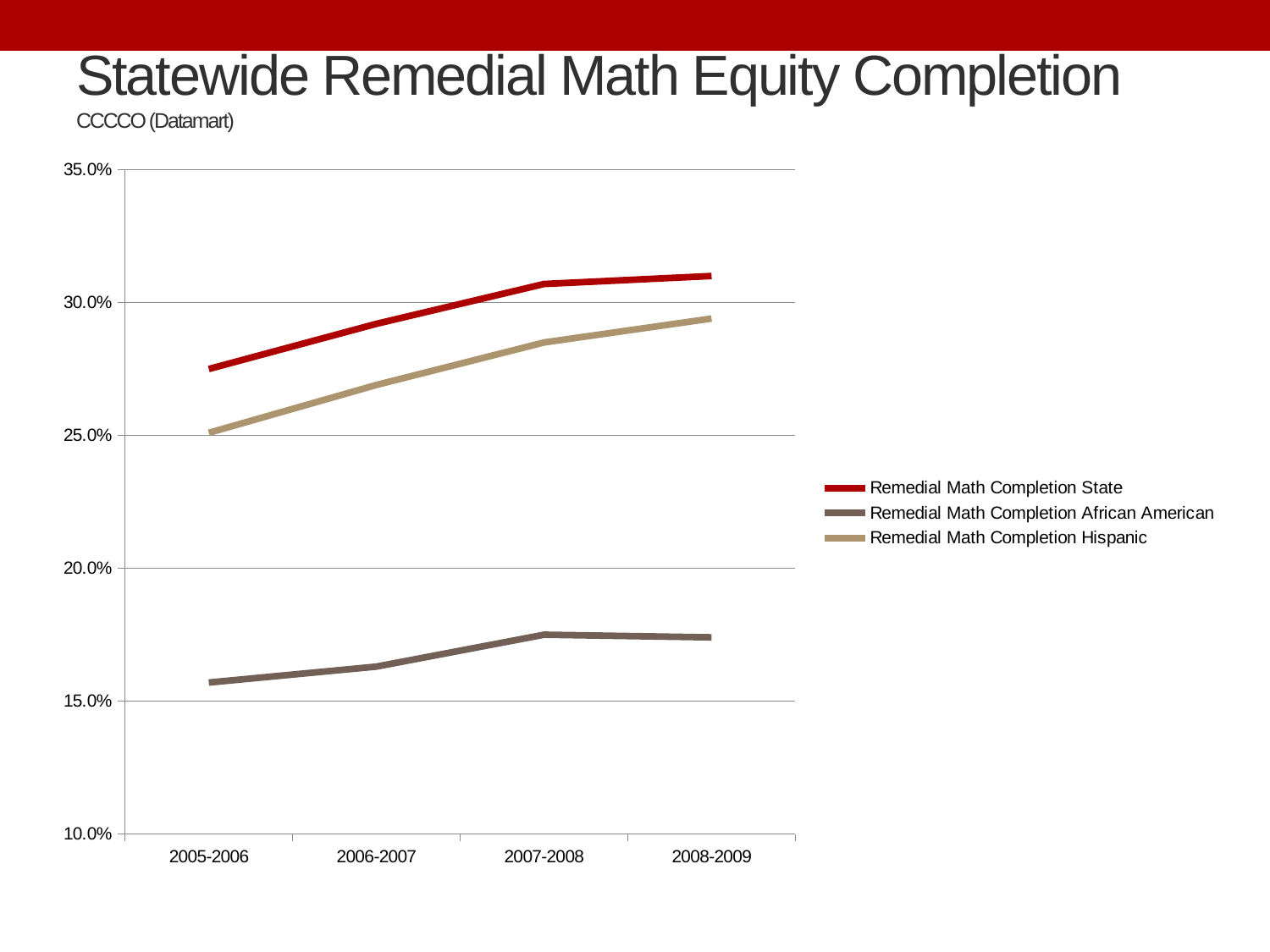
What is the title of the chart on the slide? Statewide Remedial Math Equity Completion How many academic years are shown on the x axis? 4 Does the Remedial Math Completion State line rise or fall from 2005-2006 to 2008-2009? rise Is the value for Remedial Math Completion Hispanic in 2008-2009 greater or less than 30.0%? less How many series does the legend list? 3 In 2007-2008, which is larger: Remedial Math Completion Hispanic or Remedial Math Completion African American? Remedial Math Completion Hispanic Which series has the lowest value in 2005-2006? Remedial Math Completion African American Is the value for Remedial Math Completion State in 2005-2006 greater or less than 25.0%? greater Is the value for Remedial Math Completion State in 2008-2009 greater or less than 30.0%? greater Which series has the highest value in 2008-2009? Remedial Math Completion State What kind of chart is shown on the slide? line chart